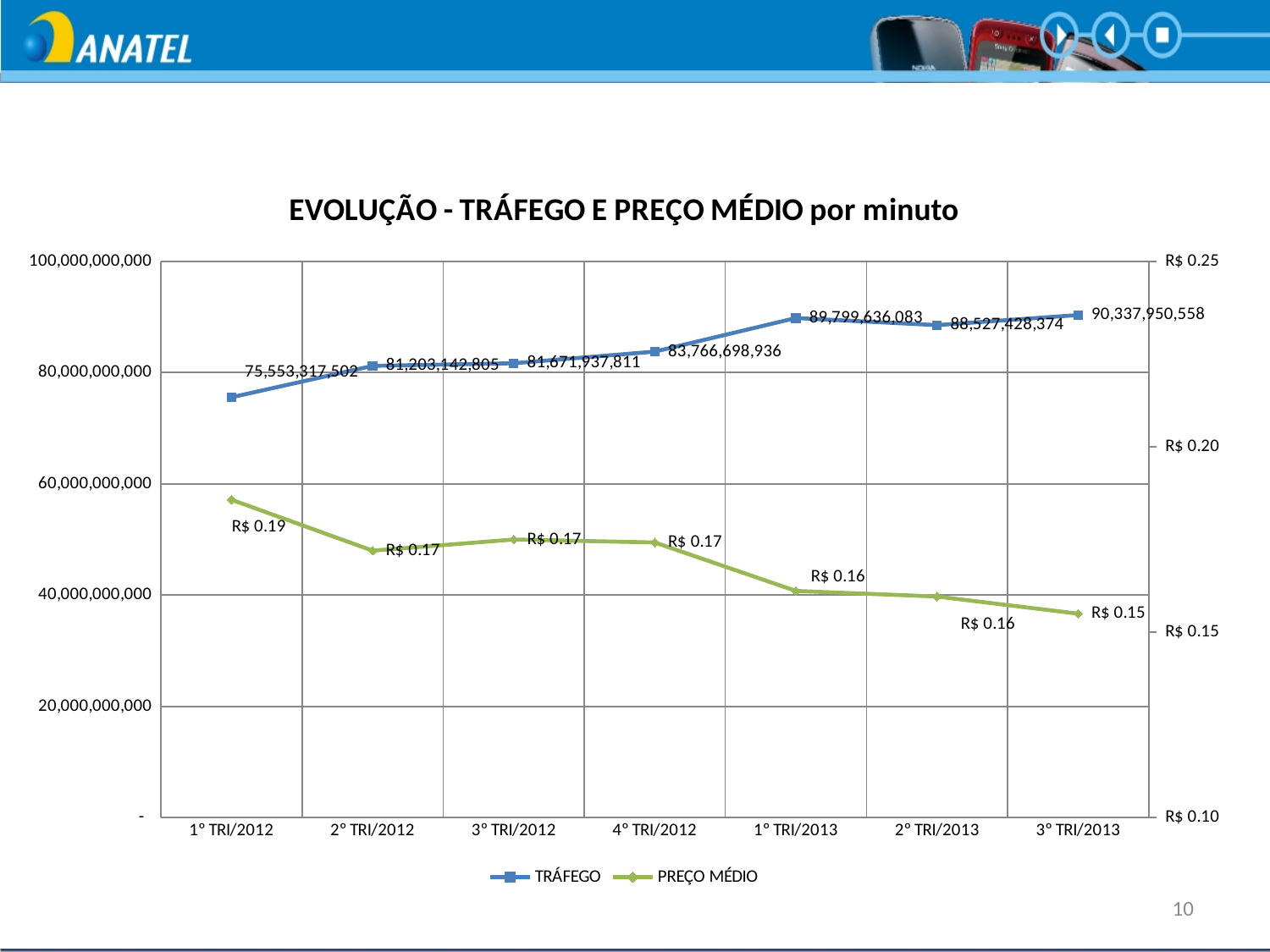
What is the PREÇO MÉDIO value for 1° TRI/2012? R$ 0.19 How many series does the legend list? 2 Which is larger, the TRÁFEGO value for 1° TRI/2013 or for 2° TRI/2013? 1° TRI/2013 What kind of chart is shown on the slide? Line chart What is the TRÁFEGO value for 3° TRI/2013? 90,337,950,558 Which quarter has the lowest TRÁFEGO value? 1° TRI/2012 What is the difference between the TRÁFEGO values for 3° TRI/2013 and 1° TRI/2012? 14,784,633,056 What is the TRÁFEGO value for 1° TRI/2012? 75,553,317,502 Does the PREÇO MÉDIO series generally rise or fall from 1° TRI/2012 to 3° TRI/2013? Fall What is the PREÇO MÉDIO value for 3° TRI/2013? R$ 0.15 How many quarters are shown on the x axis? 7 Which quarter has the highest TRÁFEGO value? 3° TRI/2013